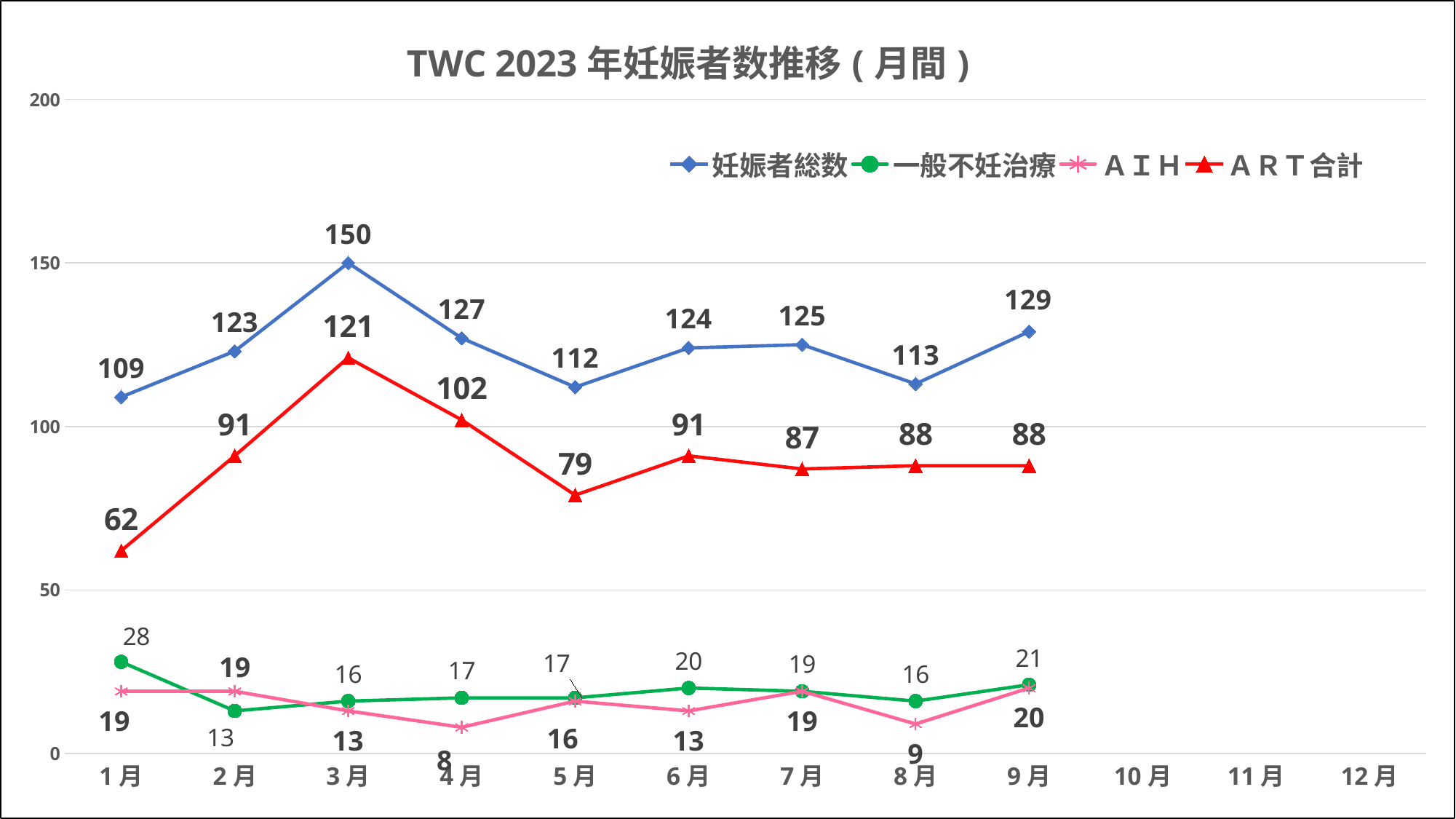
What is the value of ＡＩＨ in 4月? 8 In which month is ＡＲＴ合計 highest? 3月 In which month is 妊娠者総数 highest? 3月 What is the value of ＡＲＴ合計 in 5月? 79 In 1月, which is larger: 一般不妊治療 or ＡＩＨ? 一般不妊治療 What is the difference between 妊娠者総数 and ＡＲＴ合計 in 3月? 29 In which month is 妊娠者総数 lowest? 1月 How many months have data points plotted? 9 What is the title of the chart? TWC 2023 年妊娠者数推移（月間） What kind of chart is shown on the slide? line chart How many series does the legend list? 4 What is the value of 妊娠者総数 in 3月? 150